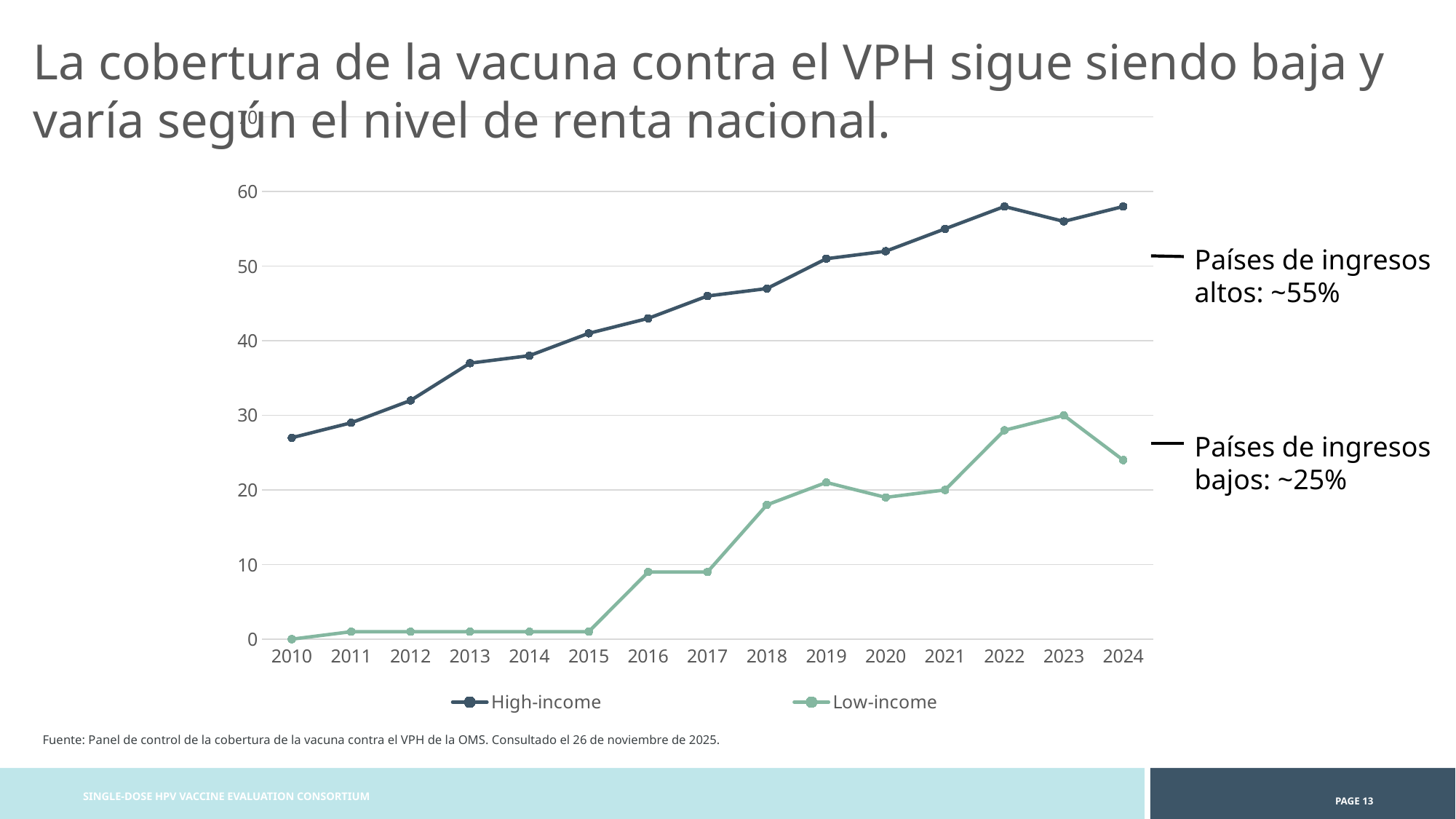
In which year is the High-income series at its lowest? 2010 Is the High-income value for 2024 greater or less than 50? greater What kind of chart is shown on the slide? line chart Is the High-income value for 2010 greater or less than 30? less How many series does the legend list? 2 What is the Low-income value in 2010? 0 Does the High-income series generally rise or fall from 2010 to 2024? rise What is the Low-income value in 2023? 30 In which year is the Low-income series at its highest? 2023 Which series does the legend list first? High-income How many years are shown along the x axis? 15